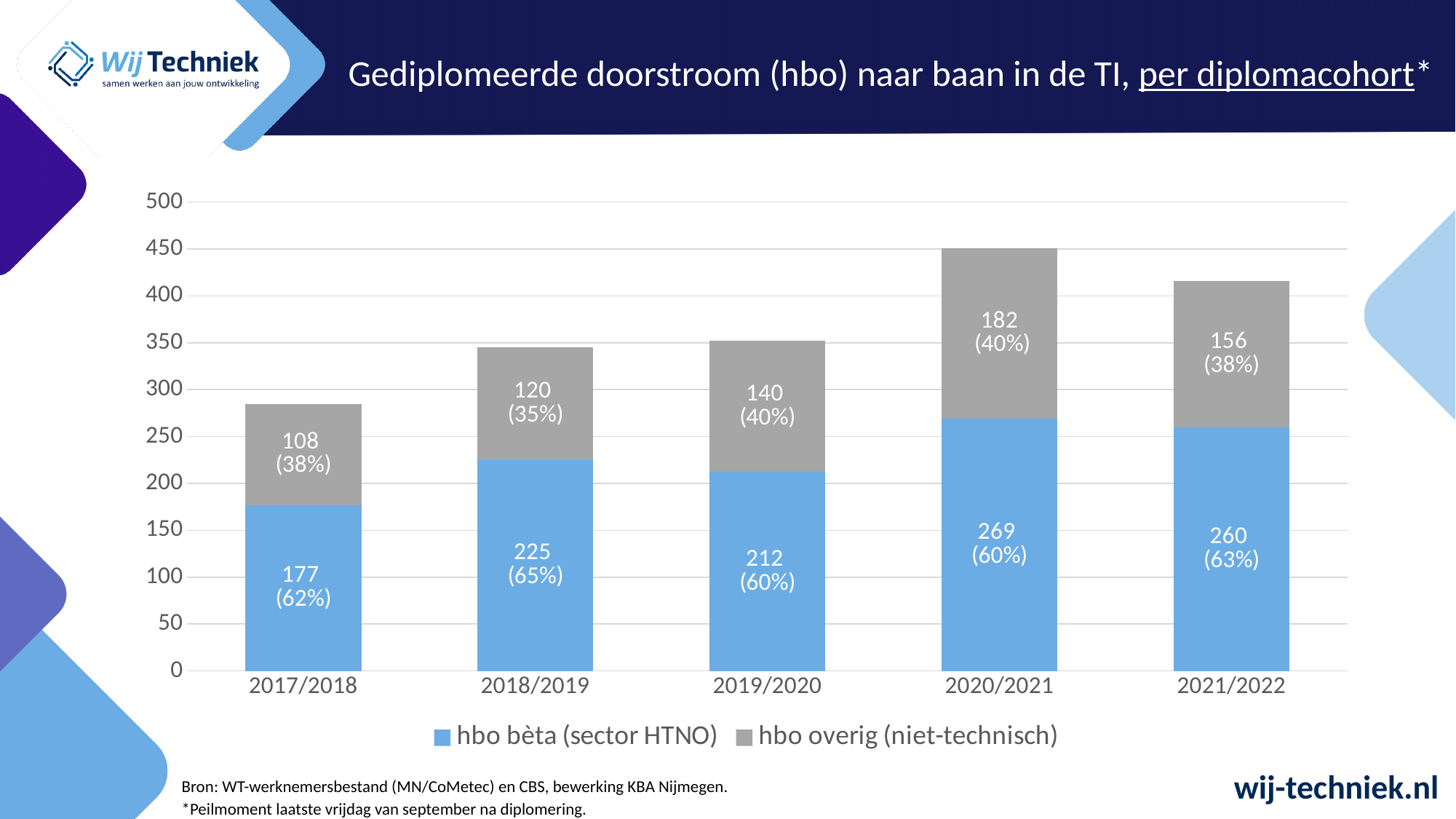
What is the total of the stacked bar for 2020/2021? 451 What is the value for hbo bèta (sector HTNO) in 2017/2018? 177 What kind of chart is shown on the slide? Stacked bar chart How many series does the legend list? 2 What percentage share is shown for hbo bèta (sector HTNO) in 2018/2019? 65% What is the difference between the hbo bèta (sector HTNO) values for 2020/2021 and 2021/2022? 9 Which cohort has the highest value for hbo bèta (sector HTNO)? 2020/2021 Which cohort has the lowest value for hbo overig (niet-technisch)? 2017/2018 What is the total of the stacked bar for 2017/2018? 285 Which is larger: hbo overig (niet-technisch) in 2019/2020 or in 2018/2019? 2019/2020 What is the value for hbo overig (niet-technisch) in 2020/2021? 182 How many diploma cohorts are shown on the x axis? 5